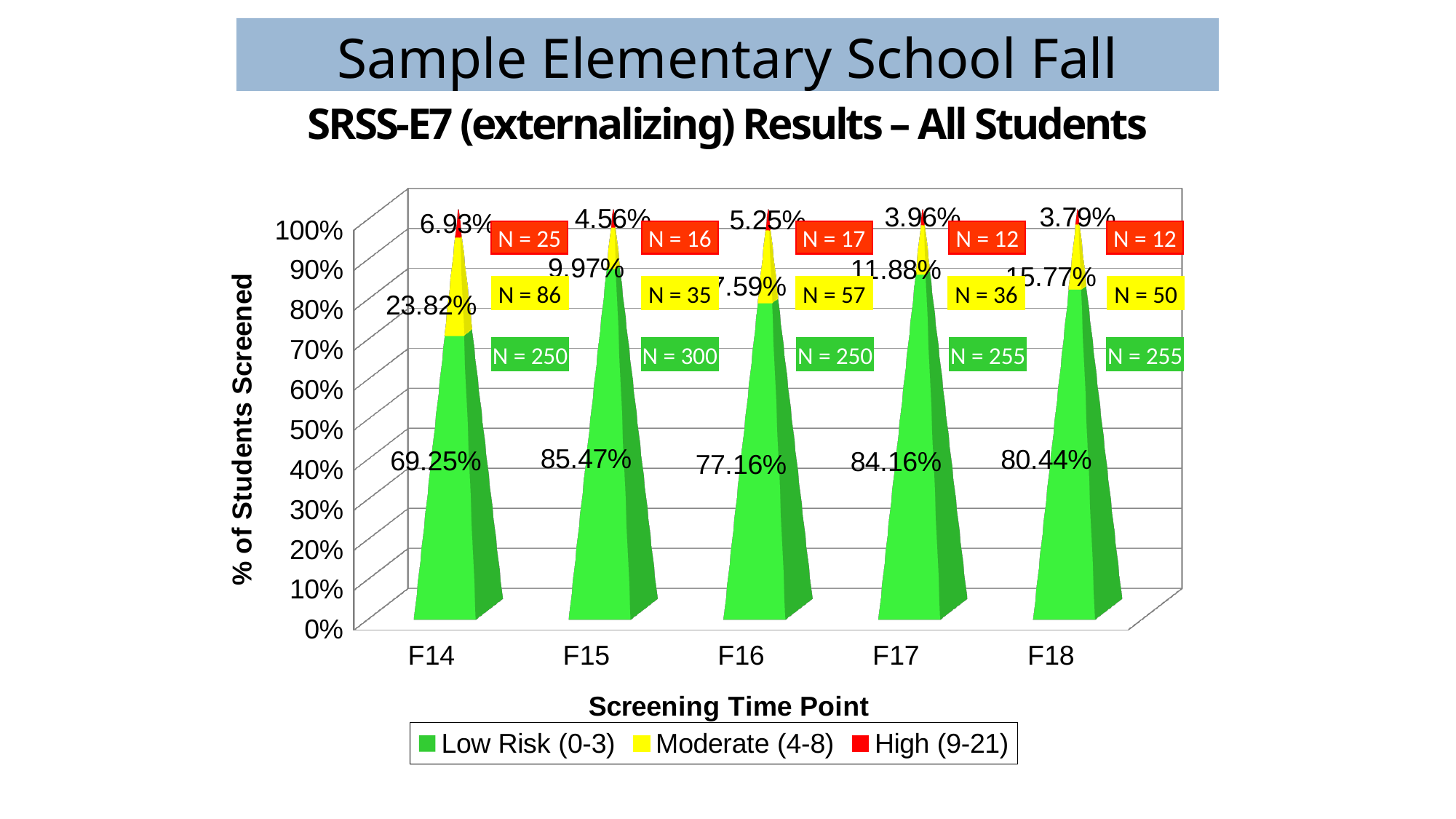
What percentage of students were High (9-21) at F16? 5.25% What is the label of the y axis? % of Students Screened How many series does the legend list? 3 At which screening time point was the Moderate (4-8) percentage highest? F14 Which is larger: the Moderate (4-8) percentage at F17 or at F16? F16 What kind of chart is shown? stacked bar chart What percentage of students were Moderate (4-8) at F18? 15.77% At which screening time point was the Low Risk (0-3) percentage highest? F15 At which screening time point was the High (9-21) percentage lowest? F18 What is the difference between the Low Risk (0-3) percentages at F15 and F14? 16.22% How many screening time points are shown on the x axis? 5 What percentage of students were Low Risk (0-3) at F14? 69.25%